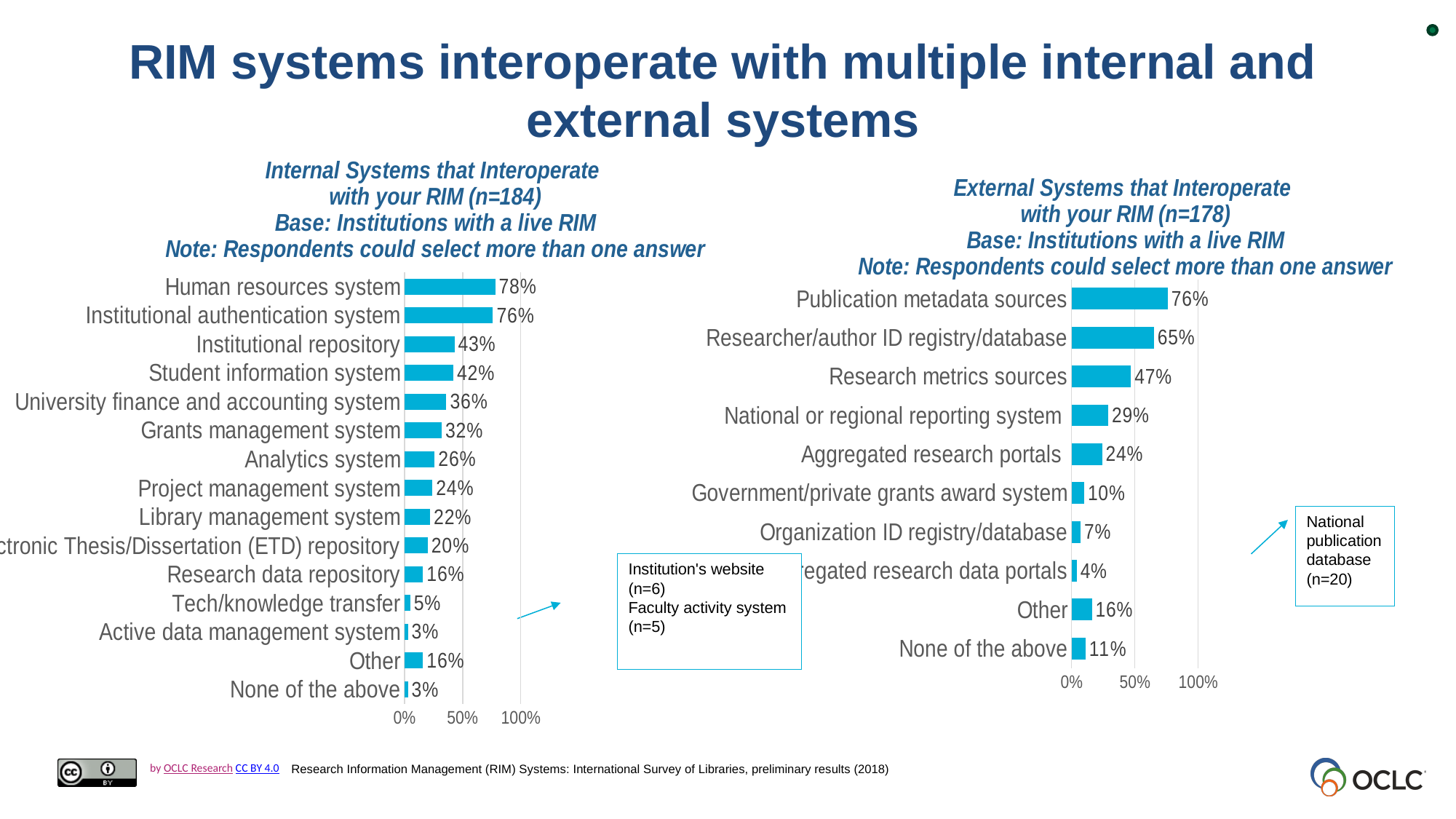
What is the sample size (n) given in the title of the External Systems chart? n=178 In the External Systems chart, is the value for National or regional reporting system greater or less than 50%? less In the External Systems chart, which category has the lowest percentage? Aggregated research data portals In the External Systems chart, what percentage is shown for Research metrics sources? 47% In the Internal Systems chart, which is larger: Analytics system or Library management system? Analytics system In the Internal Systems chart, what percentage is shown for Human resources system? 78% In the External Systems chart, what is the difference between Publication metadata sources and Researcher/author ID registry/database? 11% In the Internal Systems chart, what percentage is shown for Grants management system? 32% What kind of chart is the Internal Systems chart? Bar chart In the Internal Systems chart, what is the difference between Institutional repository and Student information system? 1% How many categories are shown in the External Systems chart? 10 In the External Systems chart, which category has the highest percentage? Publication metadata sources